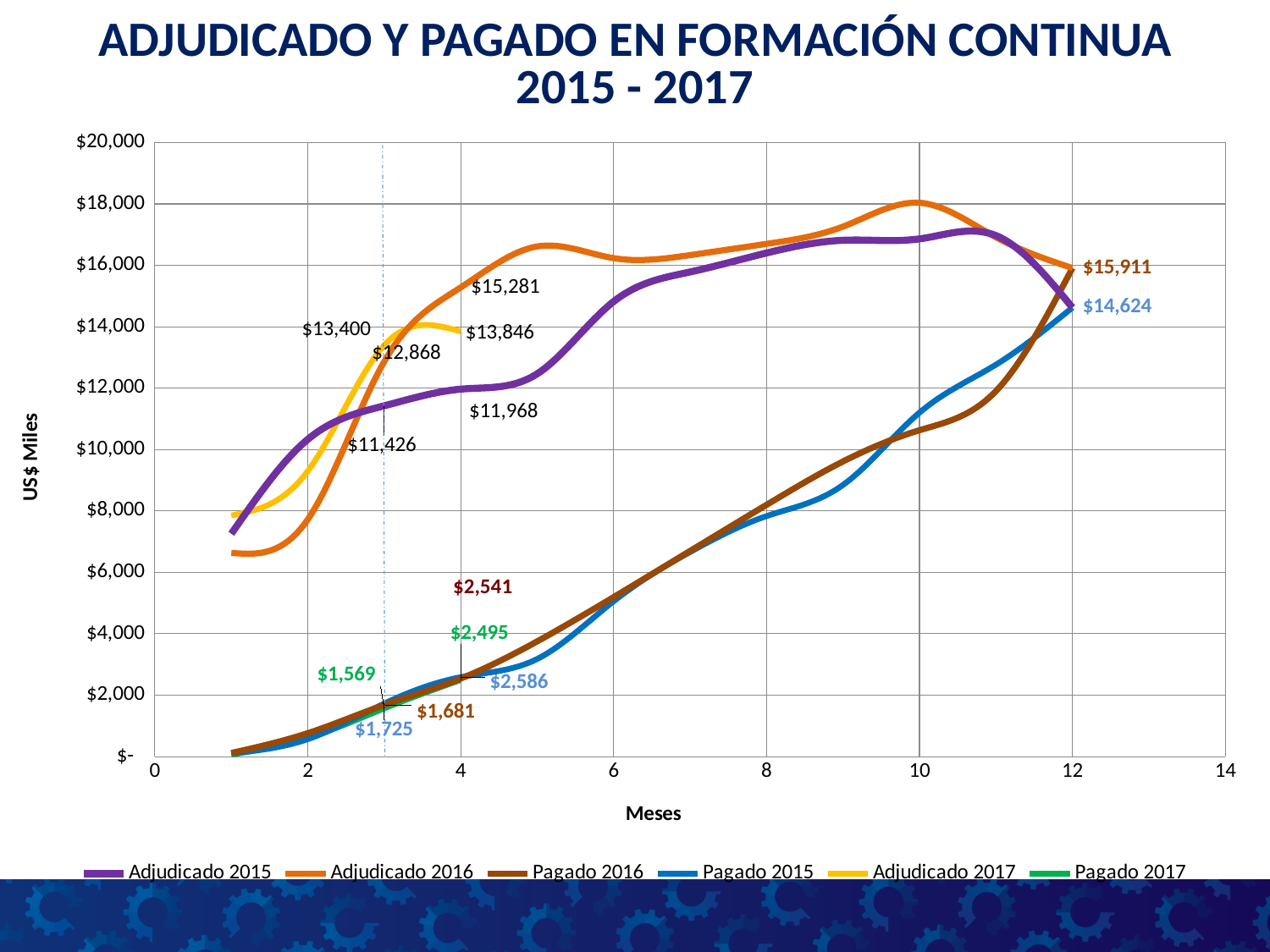
What is the value of Adjudicado 2016 at month 12? $15,911 What type of chart is shown on the slide? Line chart What is the value of Pagado 2017 at month 3? $1,569 What is the value of Pagado 2016 at month 4? $2,541 How many series does the legend list? 6 At month 4, which is larger: Pagado 2015 or Pagado 2017? Pagado 2015 Is the value of Adjudicado 2016 at month 10 greater or less than $16,000? greater What is the value of Adjudicado 2015 at month 4? $11,968 What is the difference between Adjudicado 2016 and Pagado 2015 at month 12? $1,287 What is the value of Pagado 2015 at month 12? $14,624 Which series reaches the highest value on the chart? Adjudicado 2016 What is the title of the x axis? Meses